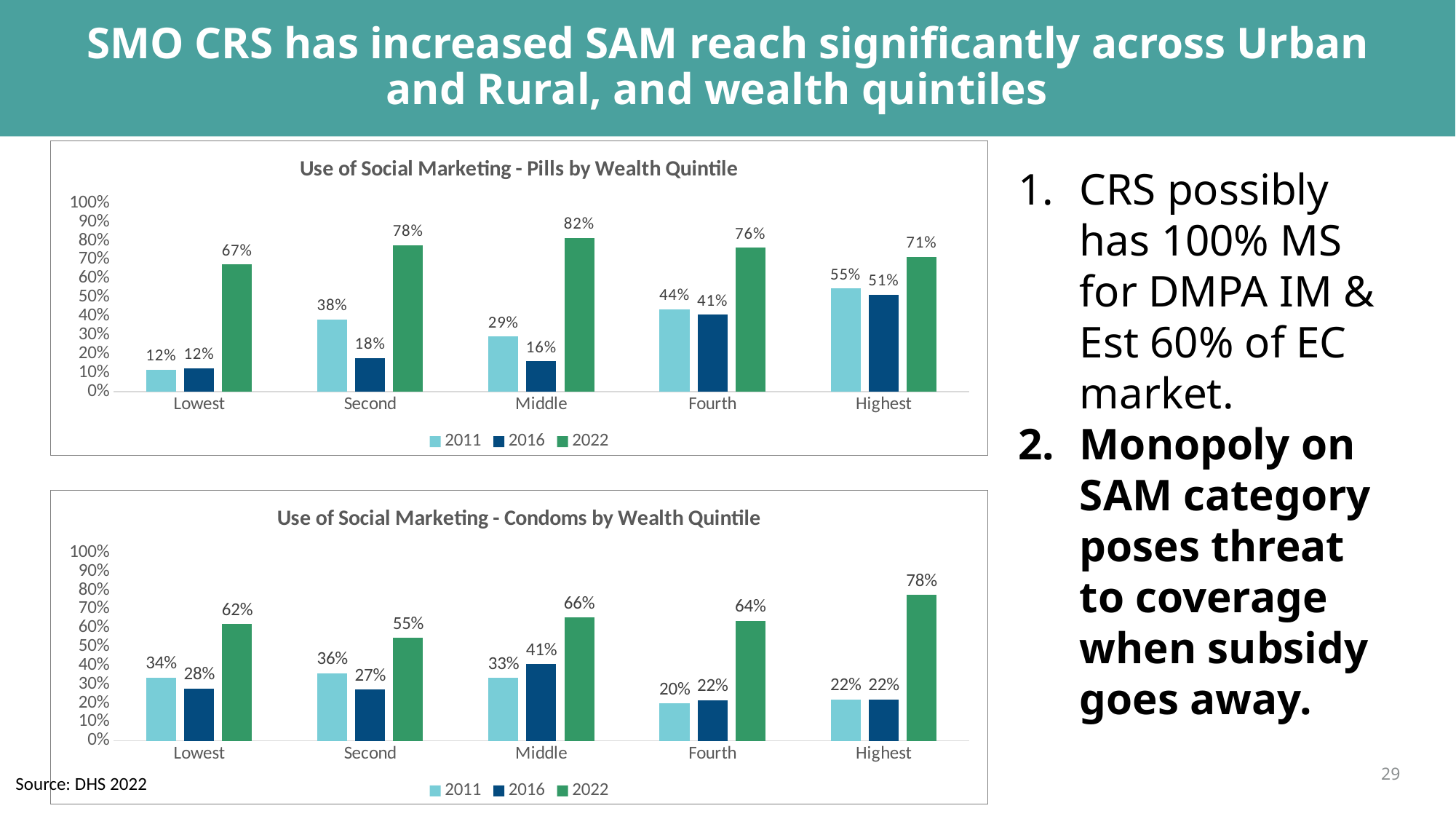
In the 'Use of Social Marketing - Pills by Wealth Quintile' chart, how many series does the legend list? 3 In the 'Use of Social Marketing - Condoms by Wealth Quintile' chart, which wealth quintile has the lowest 2011 value? Fourth In the 'Use of Social Marketing - Condoms by Wealth Quintile' chart, what is the 2016 value for the Middle quintile? 41% What source is cited at the bottom of the slide for the charts? DHS 2022 In the 'Use of Social Marketing - Pills by Wealth Quintile' chart, which wealth quintile has the highest 2011 value? Highest In the 'Use of Social Marketing - Condoms by Wealth Quintile' chart, which wealth quintile has the highest 2022 value? Highest How many wealth quintile categories are shown on the x axis of the 'Use of Social Marketing - Condoms by Wealth Quintile' chart? 5 In the 'Use of Social Marketing - Pills by Wealth Quintile' chart, what is the 2022 value for the Middle quintile? 82% In the 'Use of Social Marketing - Pills by Wealth Quintile' chart, what is the difference between the 2022 and 2016 values for the Lowest quintile? 55% What type of chart is the 'Use of Social Marketing - Pills by Wealth Quintile' chart? Bar chart In the 'Use of Social Marketing - Condoms by Wealth Quintile' chart, what is the difference between the 2022 values for the Highest and Second quintiles? 23% In the 'Use of Social Marketing - Pills by Wealth Quintile' chart, which is larger for the Fourth quintile: the 2011 value or the 2016 value? 2011